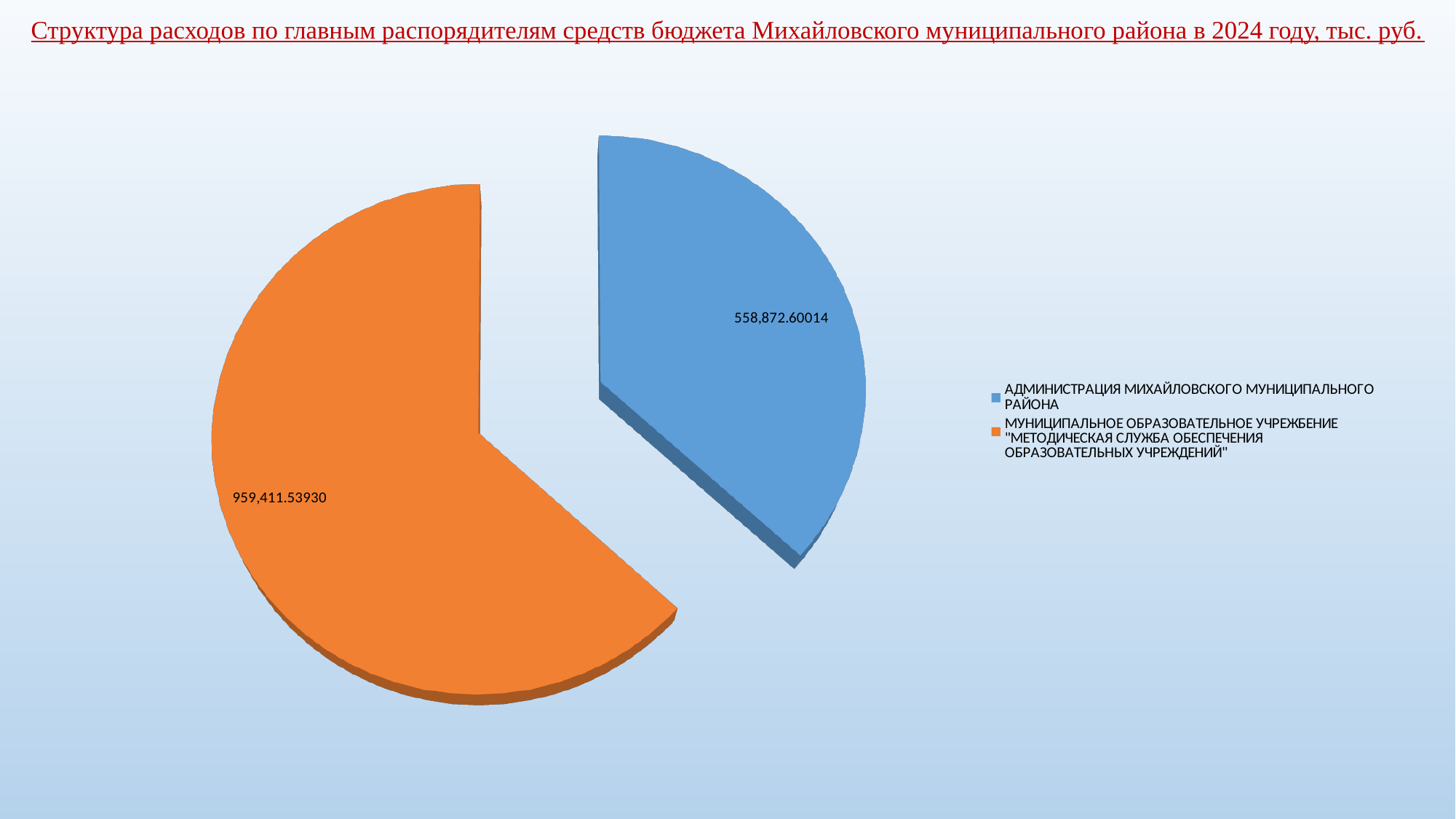
What type of chart is shown on the slide? pie chart Which category has the smallest slice of the pie? АДМИНИСТРАЦИЯ МИХАЙЛОВСКОГО МУНИЦИПАЛЬНОГО РАЙОНА What is the total of the two values shown in the pie chart? 1,518,284.13944 What is the value for АДМИНИСТРАЦИЯ МИХАЙЛОВСКОГО МУНИЦИПАЛЬНОГО РАЙОНА? 558,872.60014 What is the title of the slide? Структура расходов по главным распорядителям средств бюджета Михайловского муниципального района в 2024 году, тыс. руб. Which is larger: the value for АДМИНИСТРАЦИЯ МИХАЙЛОВСКОГО МУНИЦИПАЛЬНОГО РАЙОНА or the value for the МЕТОДИЧЕСКАЯ СЛУЖБА institution? МЕТОДИЧЕСКАЯ СЛУЖБА institution What is the value for МУНИЦИПАЛЬНОЕ ОБРАЗОВАТЕЛЬНОЕ УЧРЕЖБЕНИЕ "МЕТОДИЧЕСКАЯ СЛУЖБА ОБЕСПЕЧЕНИЯ ОБРАЗОВАТЕЛЬНЫХ УЧРЕЖДЕНИЙ"? 959,411.53930 What colour is the slice for АДМИНИСТРАЦИЯ МИХАЙЛОВСКОГО МУНИЦИПАЛЬНОГО РАЙОНА? blue What is the difference between the value for the МЕТОДИЧЕСКАЯ СЛУЖБА institution and the value for АДМИНИСТРАЦИЯ МИХАЙЛОВСКОГО МУНИЦИПАЛЬНОГО РАЙОНА? 400,538.93916 Which category has the largest slice of the pie? МУНИЦИПАЛЬНОЕ ОБРАЗОВАТЕЛЬНОЕ УЧРЕЖБЕНИЕ "МЕТОДИЧЕСКАЯ СЛУЖБА ОБЕСПЕЧЕНИЯ ОБРАЗОВАТЕЛЬНЫХ УЧРЕЖДЕНИЙ" How many categories are shown in the pie chart? 2